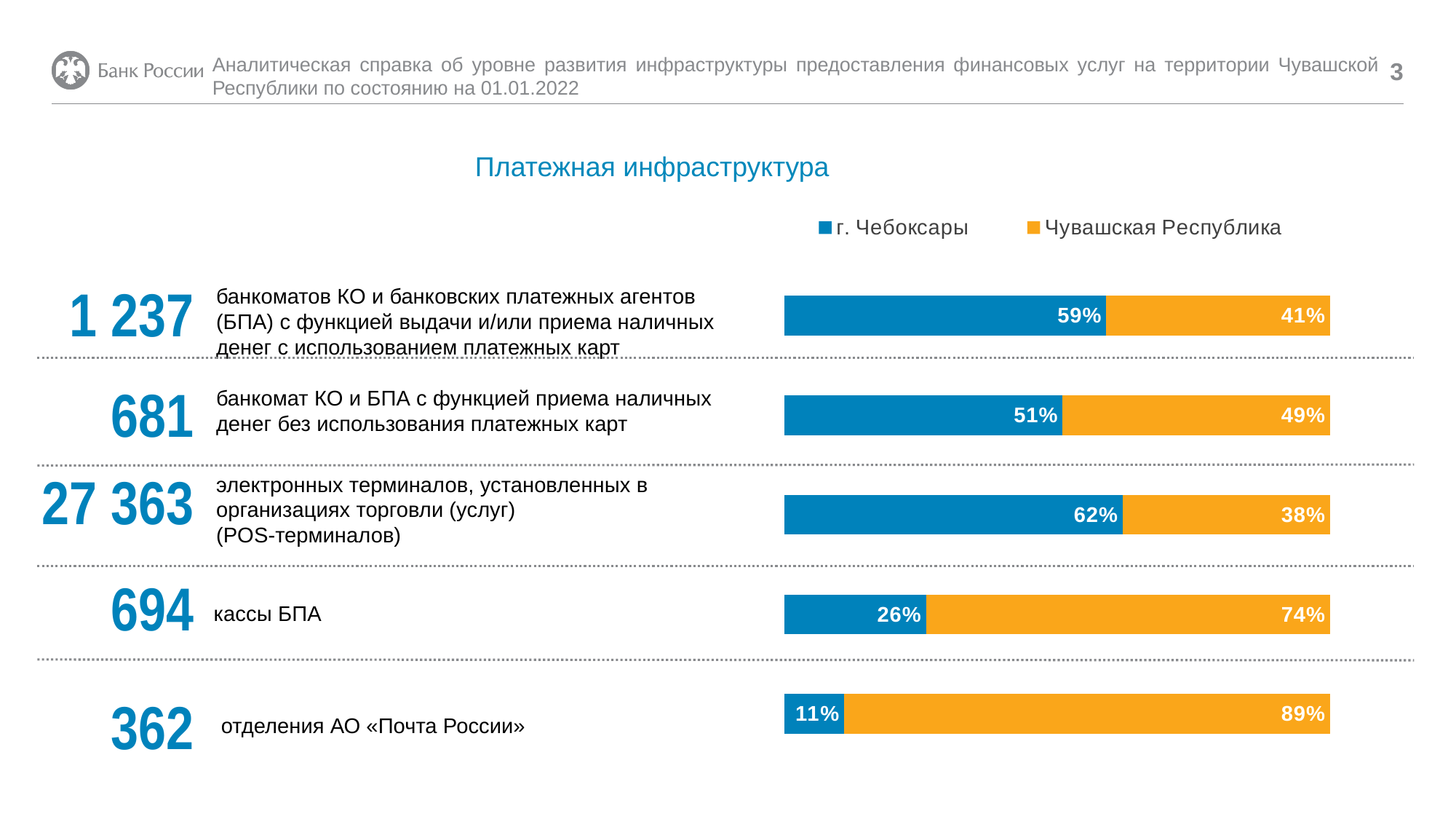
How many series does the legend list? 2 Which colour represents Чувашская Республика in the chart? orange What is the share of г. Чебоксары for отделения АО «Почта России»? 11% For банкоматов КО и БПА с функцией выдачи и/или приема наличных денег с использованием платежных карт, which series has the larger share: г. Чебоксары or Чувашская Республика? г. Чебоксары How many categories (bars) are shown in the chart? 5 What type of chart is shown on the slide? stacked bar chart What is the share of г. Чебоксары for POS-терминалов? 62% In which category is the share of г. Чебоксары the highest? электронных терминалов (POS-терминалов) In which category is the share of г. Чебоксары the lowest? отделения АО «Почта России» What is the share of Чувашская Республика for кассы БПА? 74% What is the share of Чувашская Республика for банкомат КО и БПА с функцией приема наличных денег без использования платежных карт? 49% What is the difference between the г. Чебоксары and Чувашская Республика shares for кассы БПА? 48%